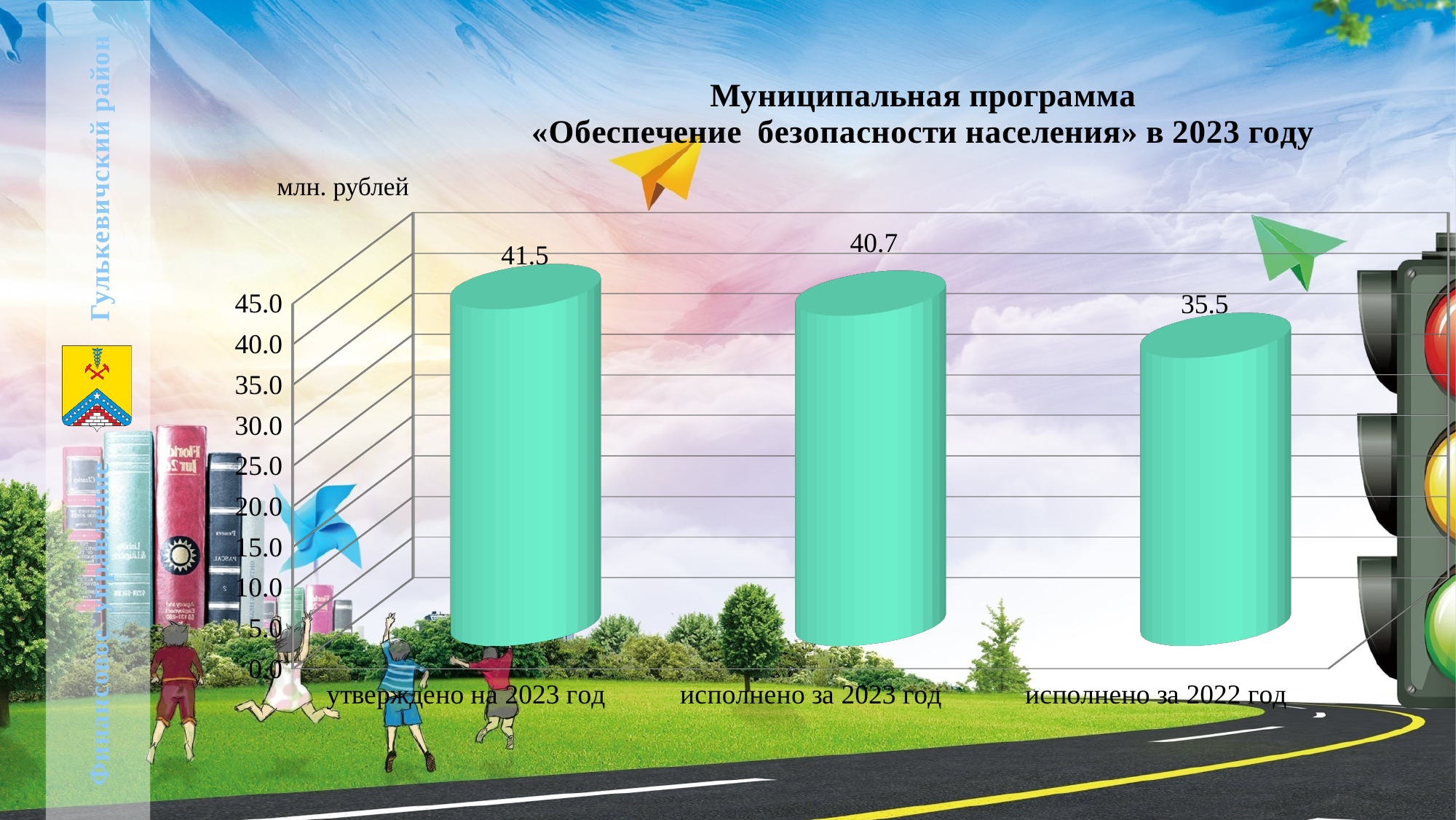
What is the difference between the values for «исполнено за 2023 год» and «исполнено за 2022 год»? 5.2 What is the difference between the values for «утверждено на 2023 год» and «исполнено за 2023 год»? 0.8 What is the value for «утверждено на 2023 год»? 41.5 Which is larger: the value for «исполнено за 2023 год» or «исполнено за 2022 год»? исполнено за 2023 год What is the value for «исполнено за 2023 год»? 40.7 Is the value for «исполнено за 2022 год» greater or less than 40.0? less Which category has the lowest value? исполнено за 2022 год What kind of chart is shown on the slide? bar chart What is the value for «исполнено за 2022 год»? 35.5 What unit is indicated for the values on the chart? млн. рублей How many categories are shown on the chart? 3 Which category has the highest value? утверждено на 2023 год